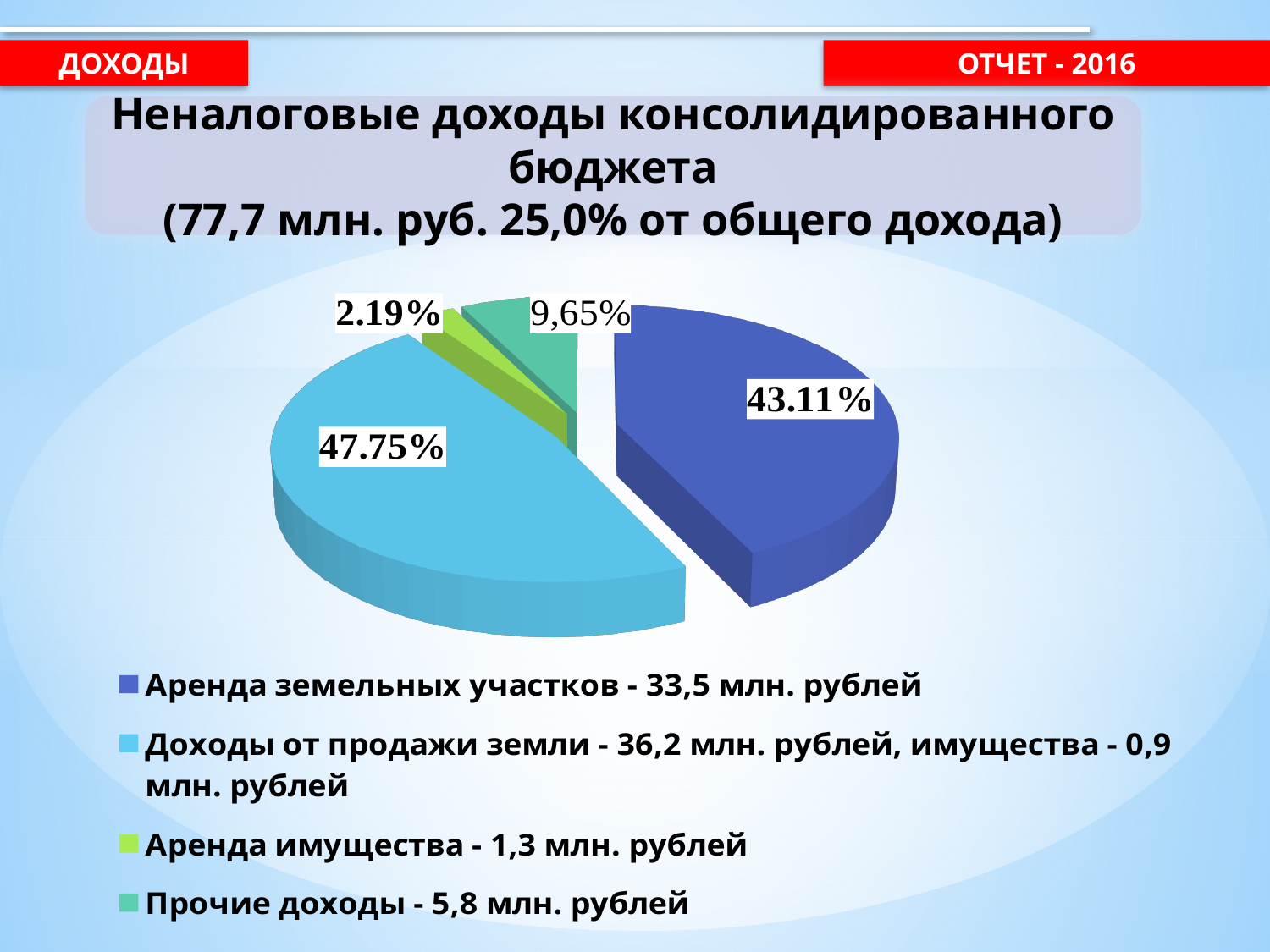
Which is larger: the share for "Прочие доходы" or the share for "Аренда имущества"? Прочие доходы What is the difference in percentage points between the shares for "Доходы от продажи земли, имущества" and "Аренда земельных участков"? 4.64 What kind of chart is shown on the slide? pie chart What share of the pie is labelled for "Аренда земельных участков"? 43.11% What amount in million rubles does the legend give for "Прочие доходы"? 5,8 млн. рублей What share of the pie is labelled for "Аренда имущества"? 2.19% Which slice of the pie chart is the largest? Доходы от продажи земли, имущества Which slice of the pie chart is the smallest? Аренда имущества What share of the pie is labelled for "Доходы от продажи земли, имущества"? 47.75% How many slices does the pie chart have? 4 How many entries does the legend list? 4